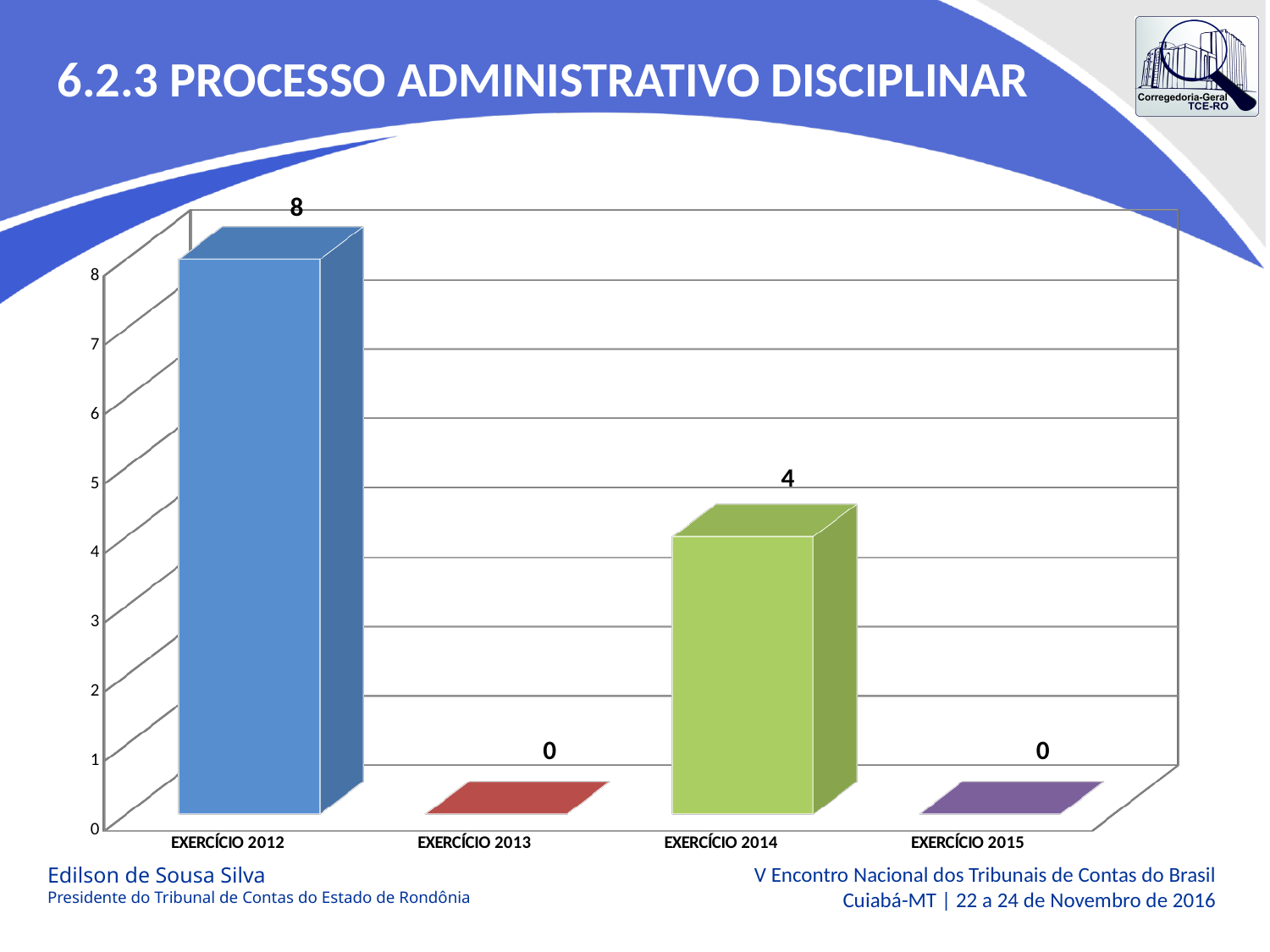
What is the value for EXERCÍCIO 2012? 8 What is the value for EXERCÍCIO 2014? 4 What is the difference between the values for EXERCÍCIO 2012 and EXERCÍCIO 2014? 4 What kind of chart is shown on the slide? bar chart How many categories have a value of 0? 2 What is the value for EXERCÍCIO 2013? 0 Which is larger, the value for EXERCÍCIO 2014 or the value for EXERCÍCIO 2015? EXERCÍCIO 2014 What is the value for EXERCÍCIO 2015? 0 What is the title of the slide containing the chart? 6.2.3 PROCESSO ADMINISTRATIVO DISCIPLINAR How many categories are shown on the x axis? 4 Which category has the highest value? EXERCÍCIO 2012 What is the total of the values across all four categories? 12